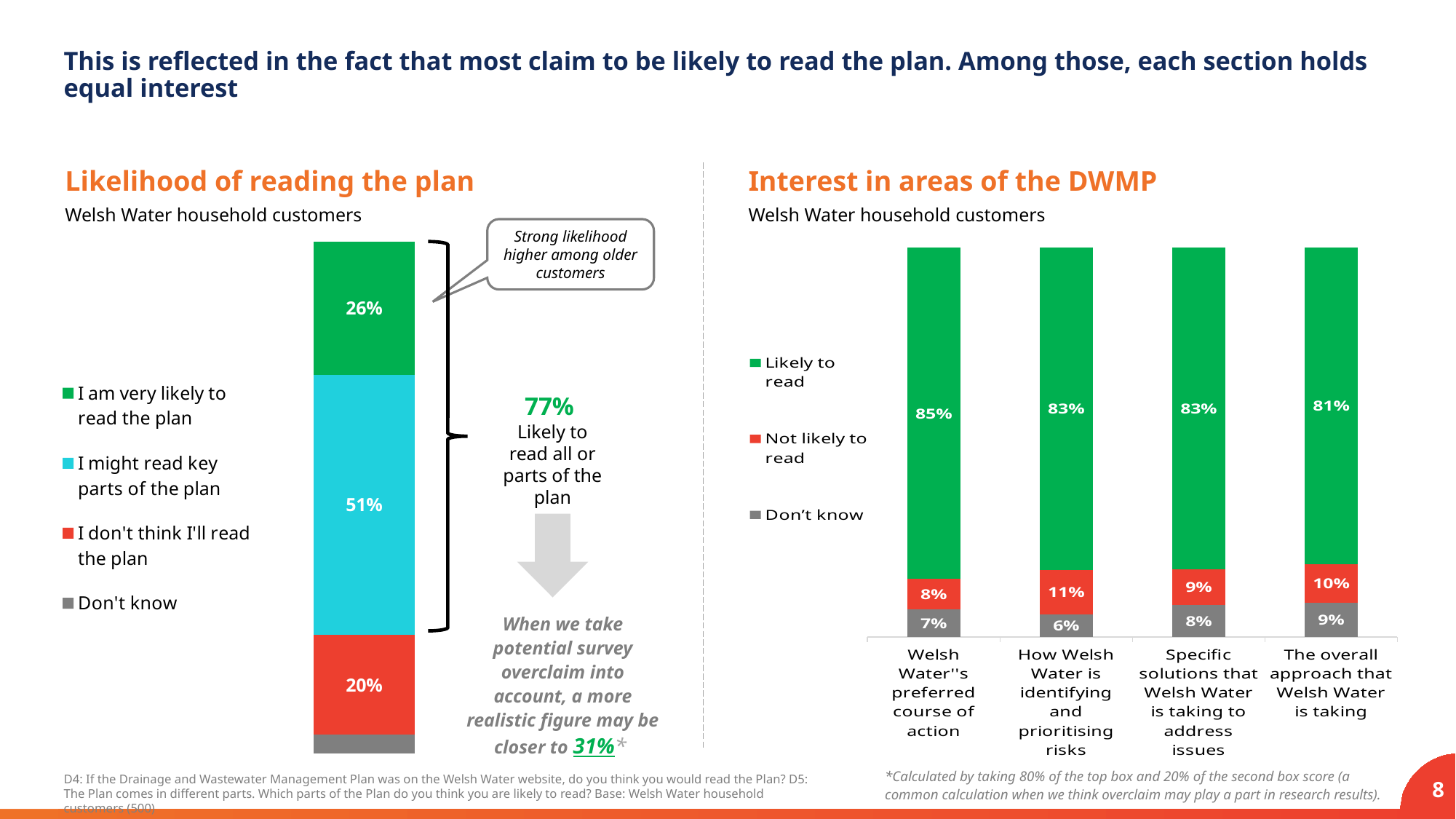
In the 'Likelihood of reading the plan' chart, what percentage of customers say they are very likely to read the plan? 26% In the 'Interest in areas of the DWMP' chart, which area has the lowest 'Likely to read' percentage? The overall approach that Welsh Water is taking In the 'Likelihood of reading the plan' chart, how many entries does the legend list? 4 In the 'Interest in areas of the DWMP' chart, how many areas are shown on the x axis? 4 What type of chart is the 'Interest in areas of the DWMP' chart? Stacked bar chart In the 'Interest in areas of the DWMP' chart, what is the 'Not likely to read' value for 'How Welsh Water is identifying and prioritising risks'? 11% In the 'Likelihood of reading the plan' chart, which response has the largest share? I might read key parts of the plan In the 'Likelihood of reading the plan' chart, what percentage say they don't think they'll read the plan? 20% In the 'Interest in areas of the DWMP' chart, what percentage are likely to read the section on Welsh Water's preferred course of action? 85% In the 'Likelihood of reading the plan' chart, what percentage say they might read key parts of the plan? 51% In the 'Interest in areas of the DWMP' chart, what is the difference between the 'Likely to read' values for 'Welsh Water's preferred course of action' and 'The overall approach that Welsh Water is taking'? 4% In the 'Interest in areas of the DWMP' chart, what is the 'Don't know' value for 'The overall approach that Welsh Water is taking'? 9%